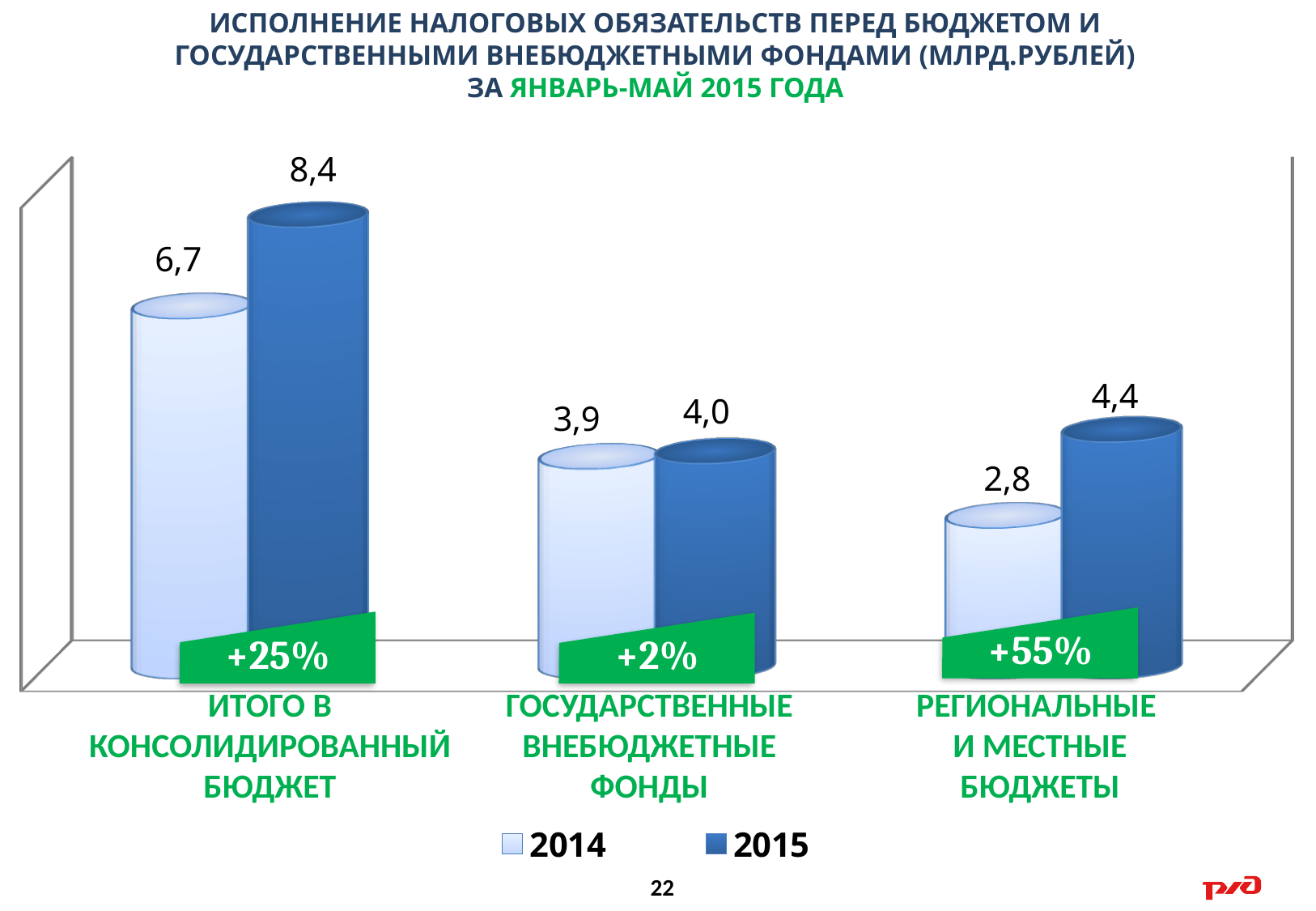
What is the difference between the 2015 and 2014 values for ИТОГО В КОНСОЛИДИРОВАННЫЙ БЮДЖЕТ? 1,7 Which category has the lowest 2014 value? РЕГИОНАЛЬНЫЕ И МЕСТНЫЕ БЮДЖЕТЫ How many series does the legend list? 2 Which category has the highest 2015 value? ИТОГО В КОНСОЛИДИРОВАННЫЙ БЮДЖЕТ What is the 2015 value for ИТОГО В КОНСОЛИДИРОВАННЫЙ БЮДЖЕТ? 8,4 What is the 2014 value for ГОСУДАРСТВЕННЫЕ ВНЕБЮДЖЕТНЫЕ ФОНДЫ? 3,9 What kind of chart is shown on the slide? Bar chart How many categories are shown on the x axis? 3 What is the 2015 value for РЕГИОНАЛЬНЫЕ И МЕСТНЫЕ БЮДЖЕТЫ? 4,4 Which is larger for РЕГИОНАЛЬНЫЕ И МЕСТНЫЕ БЮДЖЕТЫ, the 2014 value or the 2015 value? 2015 What is the 2014 value for РЕГИОНАЛЬНЫЕ И МЕСТНЫЕ БЮДЖЕТЫ? 2,8 What is the difference between the 2015 and 2014 values for РЕГИОНАЛЬНЫЕ И МЕСТНЫЕ БЮДЖЕТЫ? 1,6